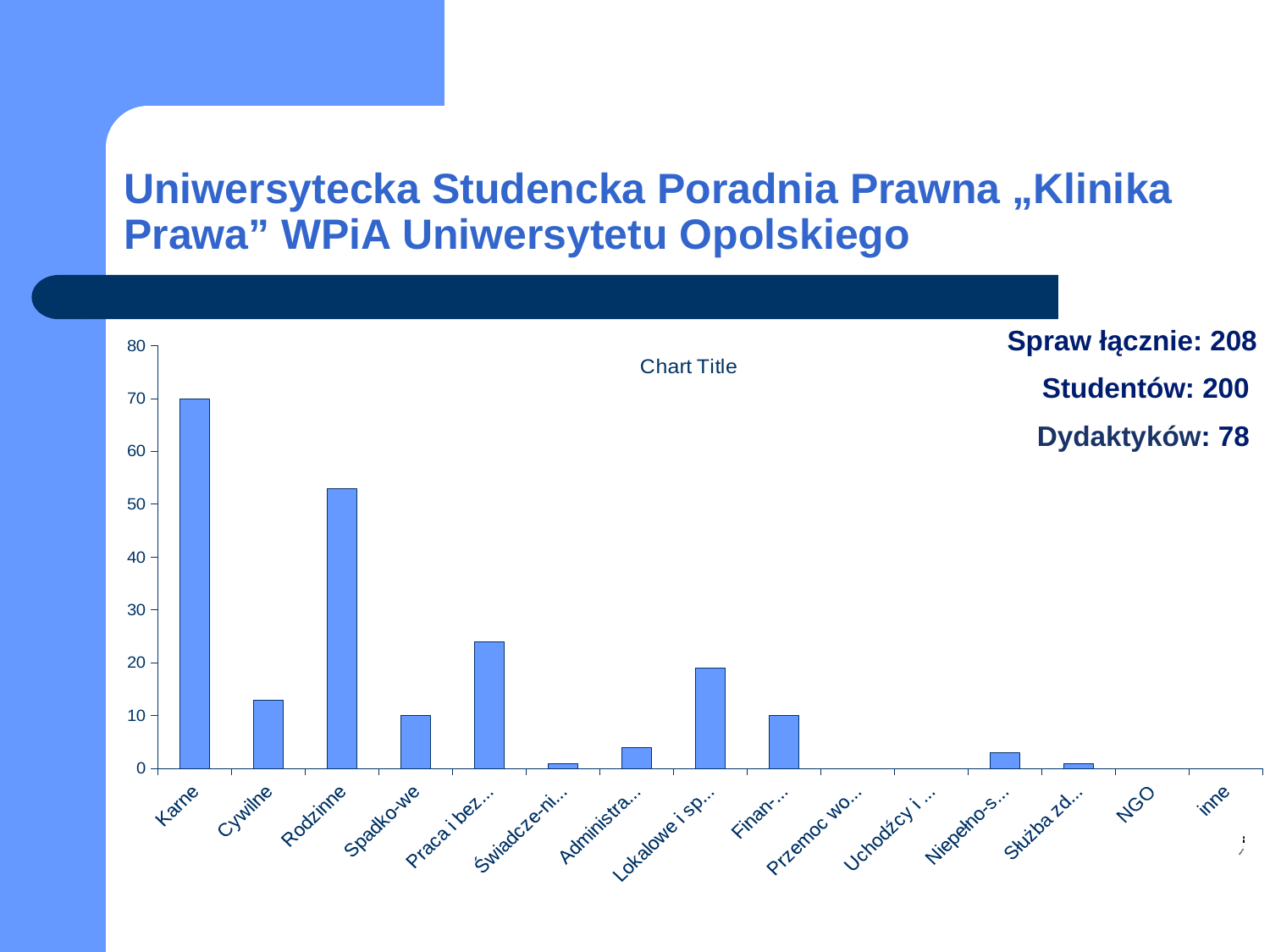
Is the value for Rodzinne greater or less than 50? greater Which is larger, the value for Rodzinne or the value for Cywilne? Rodzinne How many categories are shown on the x axis of the chart? 15 Which category has the highest value in the chart? Karne What is the value for Karne? 70 Is the value for Administra... greater or less than 10? less What is the value for Spadko-we? 10 Is the value for Praca i bez... greater or less than 20? greater What kind of chart is shown on the slide? bar chart What is the title shown on the chart? Chart Title